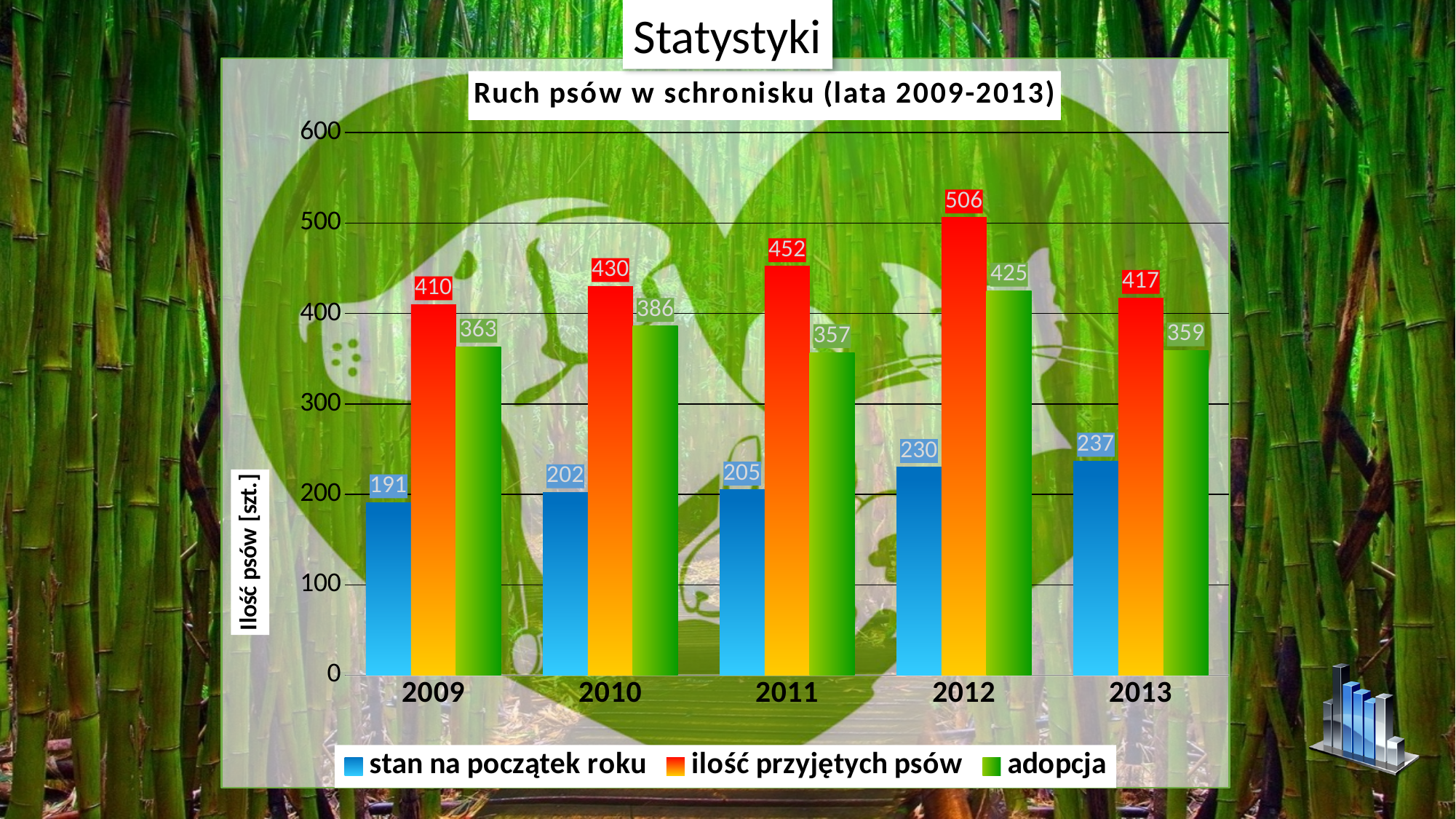
Which is larger in 2011: 'ilość przyjętych psów' or 'adopcja'? ilość przyjętych psów What is the difference between 'ilość przyjętych psów' and 'adopcja' in 2013? 58 What is the value of 'ilość przyjętych psów' for 2012? 506 What is the value of 'stan na początek roku' for 2009? 191 What kind of chart is shown? bar chart In which year is 'adopcja' lowest? 2011 Does 'stan na początek roku' rise or fall from 2009 to 2013? rise In which year is 'ilość przyjętych psów' highest? 2012 How many series does the legend list? 3 How many years are shown on the x axis? 5 Is the value of 'stan na początek roku' for 2013 greater or less than 200? greater What is the value of 'adopcja' for 2010? 386